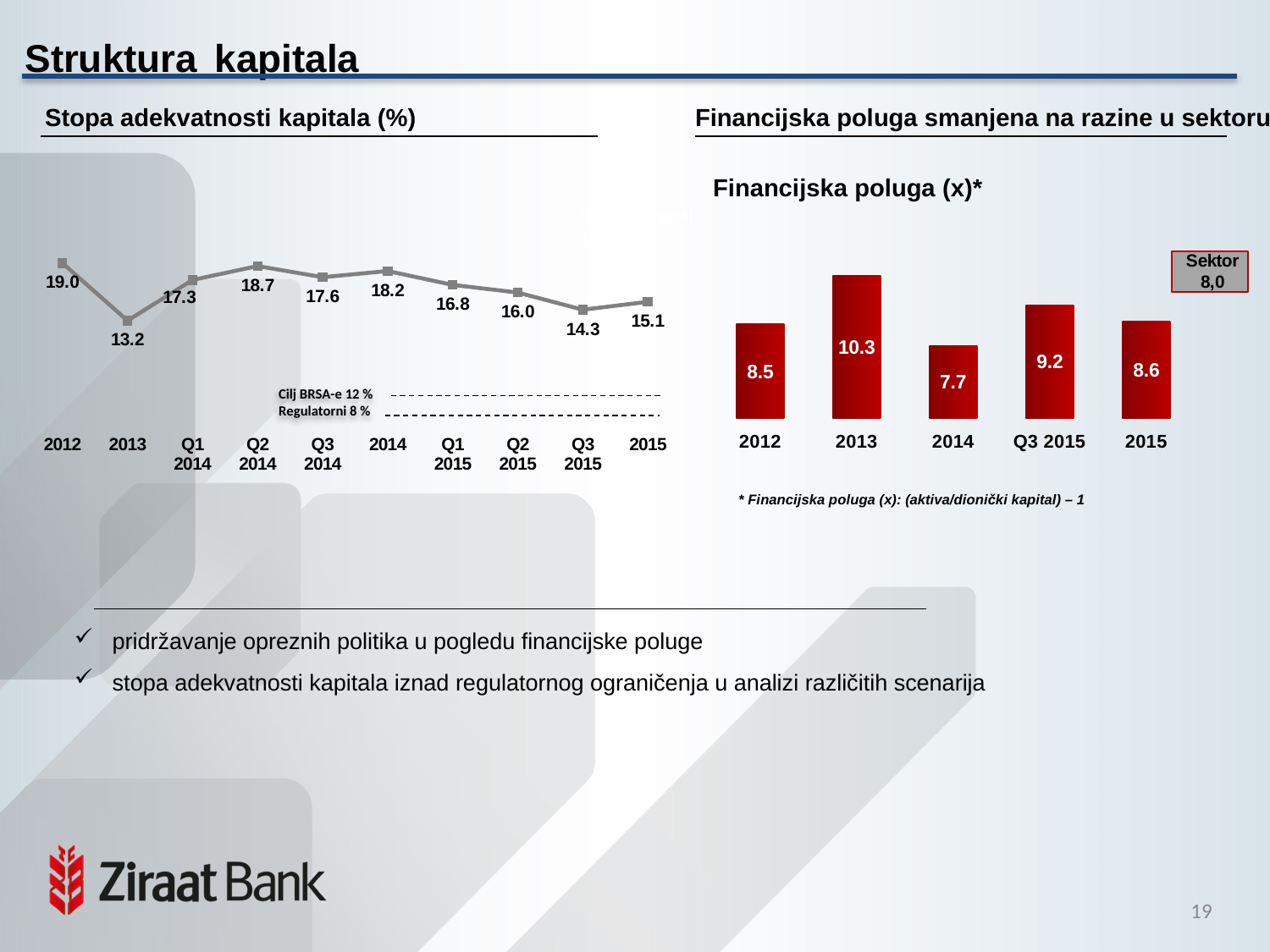
In the 'Stopa adekvatnosti kapitala (%)' chart, what is the value for Q3 2015? 14.3 In the 'Financijska poluga (x)*' chart, what is the value for 2014? 7.7 In the 'Stopa adekvatnosti kapitala (%)' chart, what is the value for 2012? 19.0 In the 'Stopa adekvatnosti kapitala (%)' chart, which period has the highest value? 2012 In the 'Stopa adekvatnosti kapitala (%)' chart, how many data points are plotted? 10 What kind of chart is the 'Stopa adekvatnosti kapitala (%)' chart? line chart What kind of chart is the 'Financijska poluga (x)*' chart? bar chart In the 'Stopa adekvatnosti kapitala (%)' chart, which period has the lowest value? 2013 In the 'Financijska poluga (x)*' chart, is the value for Q3 2015 or 2015 larger? Q3 2015 In the 'Stopa adekvatnosti kapitala (%)' chart, what is the difference between the 2012 value and the 2013 value? 5.8 In the 'Financijska poluga (x)*' chart, which year has the lowest value? 2014 In the 'Financijska poluga (x)*' chart, which year has the highest value? 2013